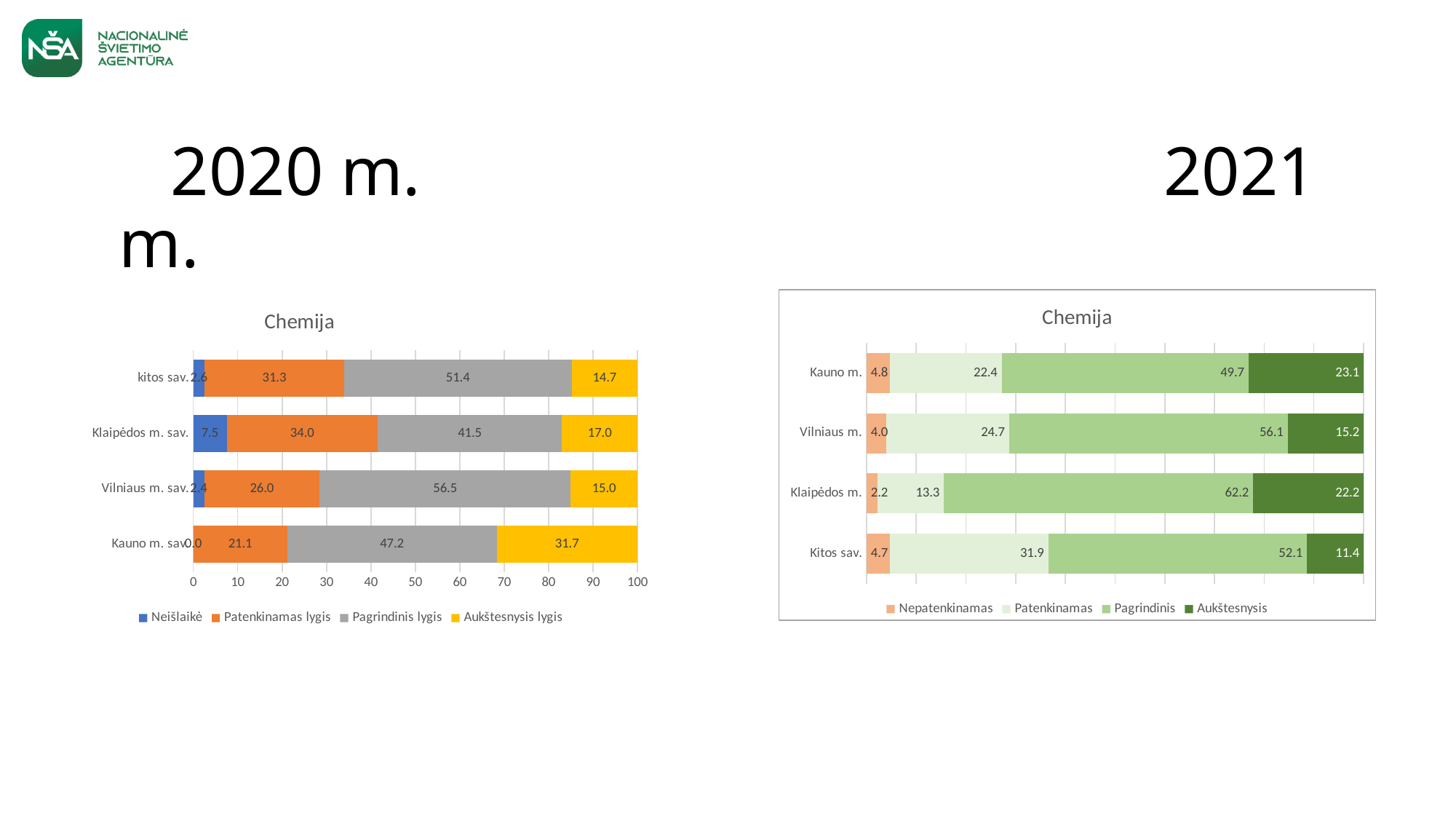
In the right chart (2021 m.), what is the difference between the Aukštesnysis values for Kauno m. and Kitos sav.? 11.7 In the right chart (2021 m.), which category has the lowest Patenkinamas value? Klaipėdos m. In the right chart (2021 m.), what is the Pagrindinis value for Klaipėdos m.? 62.2 In the left chart (2020 m.), what is the Pagrindinis lygis value for Vilniaus m. sav.? 56.5 In the left chart (2020 m.), which is larger: the Patenkinamas lygis value for Klaipėdos m. sav. or for kitos sav.? Klaipėdos m. sav. In the left chart (2020 m.), what is the total of the stacked bar for Klaipėdos m. sav.? 100.0 How many categories are shown in the right chart (2021 m.)? 4 What type of chart is the right chart (2021 m.)? Stacked bar chart In the right chart (2021 m.), what is the Nepatenkinamas value for Vilniaus m.? 4.0 In the left chart (2020 m.), which category has the highest Neišlaikė value? Klaipėdos m. sav. In the left chart (2020 m.), what is the Aukštesnysis lygis value for Kauno m. sav.? 31.7 How many series does the legend of the left chart (2020 m.) list? 4